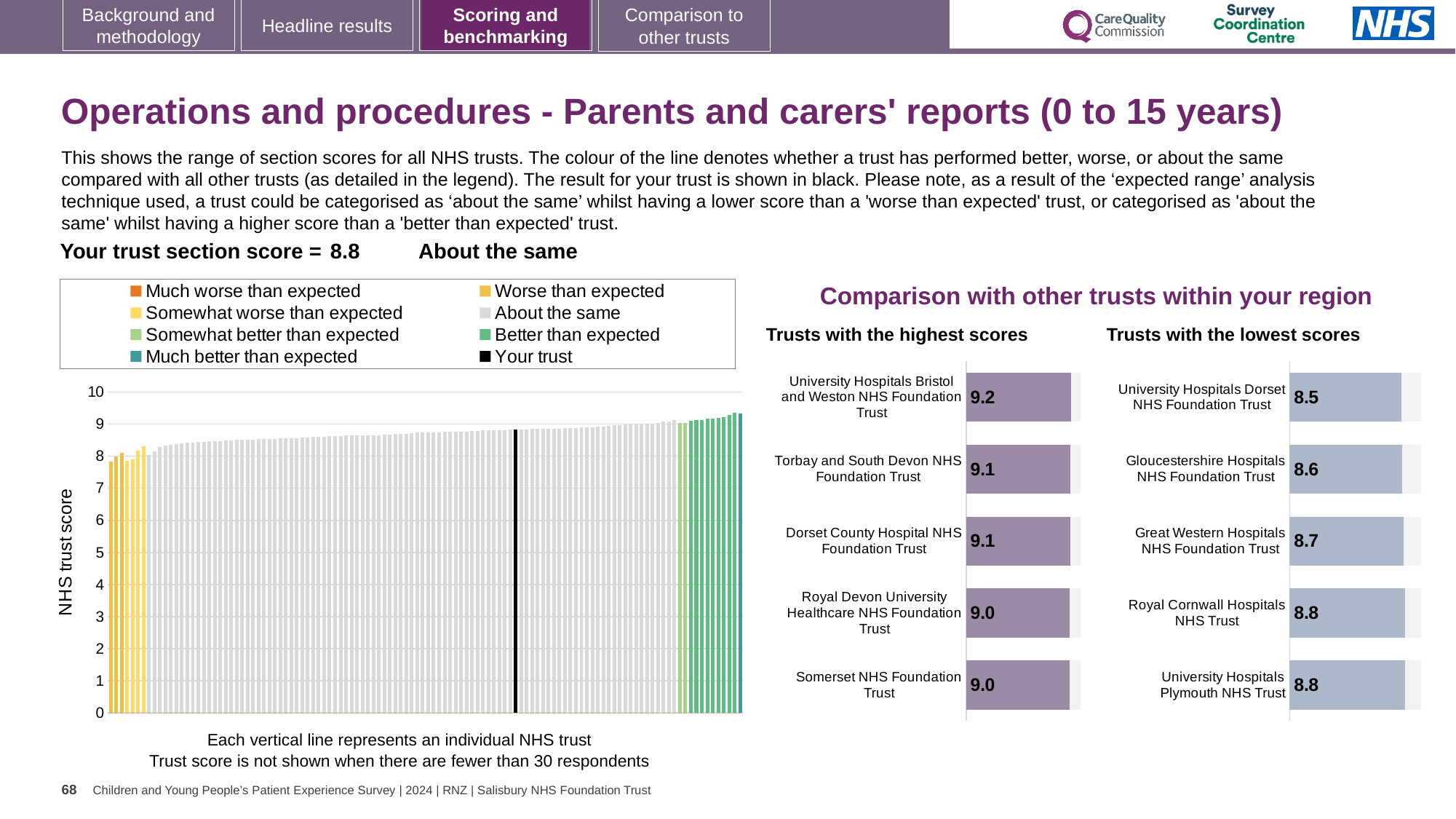
On the 'Trusts with the highest scores' chart, what is the score for University Hospitals Bristol and Weston NHS Foundation Trust? 9.2 On the 'Trusts with the highest scores' chart, what is the score for Somerset NHS Foundation Trust? 9.0 On the 'Trusts with the lowest scores' chart, what is the difference between the scores of Great Western Hospitals NHS Foundation Trust and University Hospitals Dorset NHS Foundation Trust? 0.2 On the large chart on the left, is the value of the leftmost bar greater or less than 9? less On the 'Trusts with the lowest scores' chart, which has the larger score: Gloucestershire Hospitals NHS Foundation Trust or Great Western Hospitals NHS Foundation Trust? Great Western Hospitals NHS Foundation Trust What kind of chart is the large chart on the left with the 'NHS trust score' axis? Bar chart On the 'Trusts with the lowest scores' chart, what is the score for University Hospitals Dorset NHS Foundation Trust? 8.5 On the 'Trusts with the highest scores' chart, which trust has the highest score? University Hospitals Bristol and Weston NHS Foundation Trust How many trusts are shown on the 'Trusts with the lowest scores' chart? 5 How many entries does the legend of the large chart on the left list? 8 On the 'Trusts with the lowest scores' chart, which trust has the lowest score? University Hospitals Dorset NHS Foundation Trust On the 'Trusts with the highest scores' chart, what is the difference between the scores of University Hospitals Bristol and Weston NHS Foundation Trust and Somerset NHS Foundation Trust? 0.2